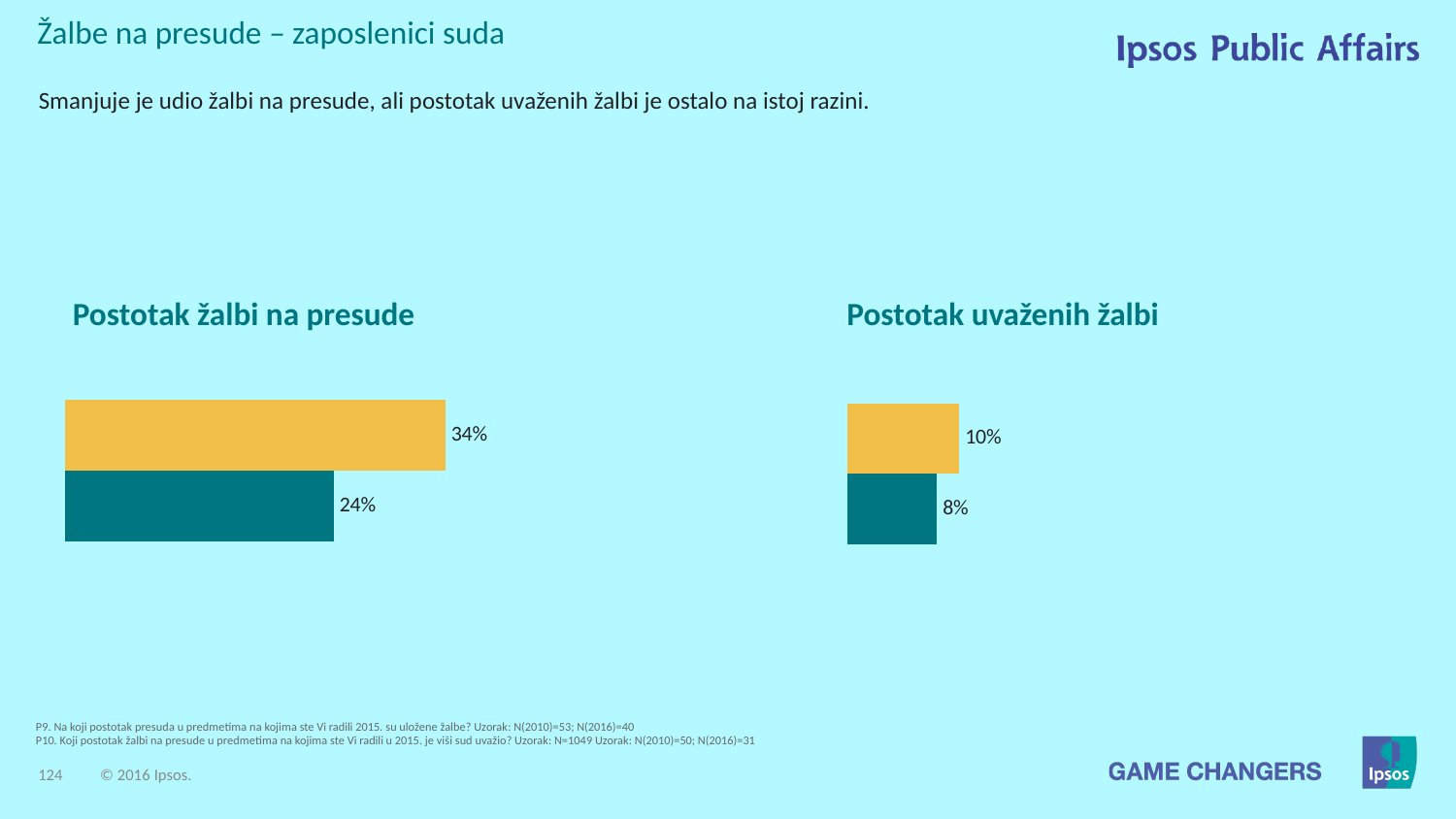
In the chart titled "Postotak žalbi na presude", what is the difference between the top bar and the bottom bar? 10 percentage points In the chart titled "Postotak uvaženih žalbi", what value is shown on the bottom (teal) bar? 8% In the chart titled "Postotak žalbi na presude", which bar is larger, the top (yellow) bar or the bottom (teal) bar? The top (yellow) bar In the chart titled "Postotak uvaženih žalbi", which bar has the lowest value? The bottom (teal) bar, 8% In the chart titled "Postotak uvaženih žalbi", what value is shown on the top (yellow) bar? 10% What is the title of the chart on the right side of the slide? Postotak uvaženih žalbi What type of chart is used for "Postotak žalbi na presude"? Bar chart In the chart titled "Postotak žalbi na presude", what value is shown on the bottom (teal) bar? 24% In the chart titled "Postotak žalbi na presude", what value is shown on the top (yellow) bar? 34% How many bars are shown in the chart titled "Postotak uvaženih žalbi"? 2 In the chart titled "Postotak uvaženih žalbi", what is the difference between the top bar and the bottom bar? 2 percentage points In the chart titled "Postotak žalbi na presude", what is the highest value shown? 34%